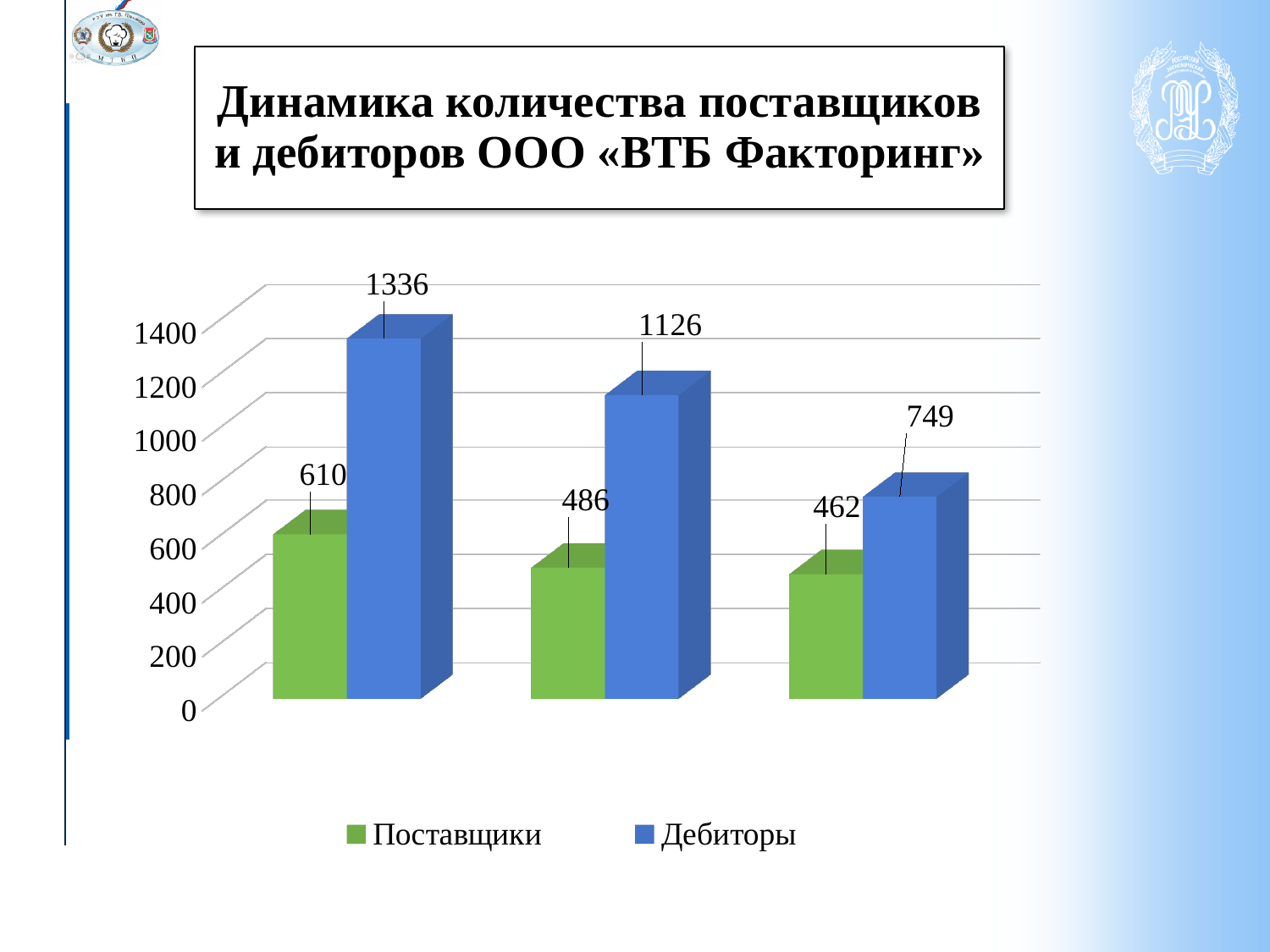
How many series does the legend list? 2 What is the value of the Дебиторы bar in the first (leftmost) group? 1336 What is the difference between the Дебиторы and Поставщики values in the first (leftmost) group? 726 Which group has the highest Дебиторы value? the first (leftmost) group Which group has the lowest Поставщики value? the third (rightmost) group What type of chart is shown on the slide? bar chart How many groups of bars are plotted in the chart? 3 Which is larger in the third (rightmost) group: Поставщики or Дебиторы? Дебиторы Do the Дебиторы values rise or fall from left to right across the groups? fall What is the value of the Поставщики bar in the second (middle) group? 486 What colour are the Поставщики bars? green What is the value of the Дебиторы bar in the third (rightmost) group? 749